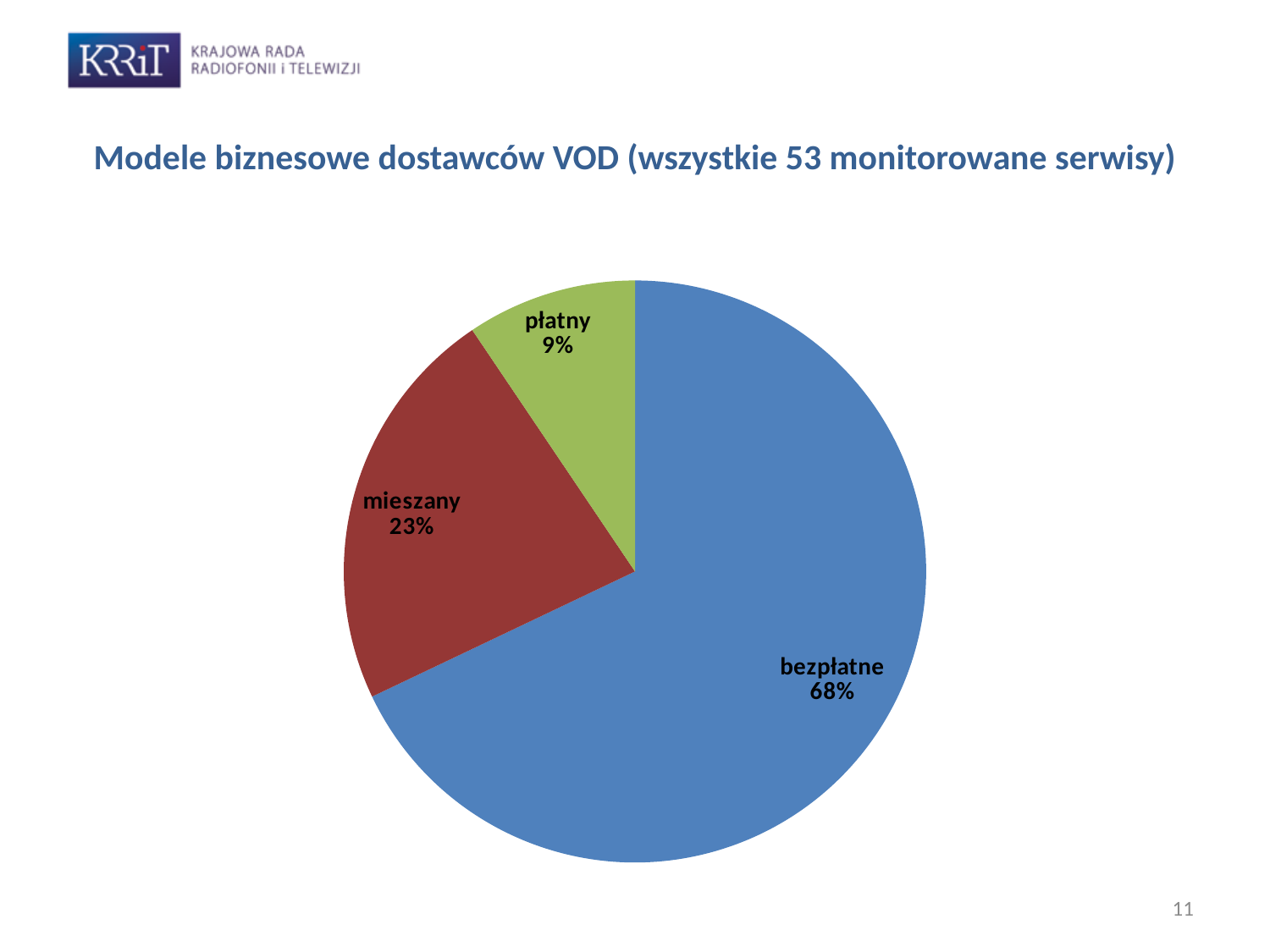
What share of the pie does the "mieszany" slice represent? 23% What is the difference in percentage points between the "mieszany" and "płatny" shares? 14 What share of the pie does the "bezpłatne" slice represent? 68% What is the difference in percentage points between the "bezpłatne" and "mieszany" shares? 45 What share of the pie does the "płatny" slice represent? 9% Which category has the largest share of the pie? bezpłatne What colour is the "mieszany" slice? red Which category has the smallest share of the pie? płatny What is the title of the chart on the slide? Modele biznesowe dostawców VOD (wszystkie 53 monitorowane serwisy) What kind of chart is shown on the slide? pie chart How many slices does the pie chart have? 3 Which is larger, the share for "mieszany" or the share for "płatny"? mieszany